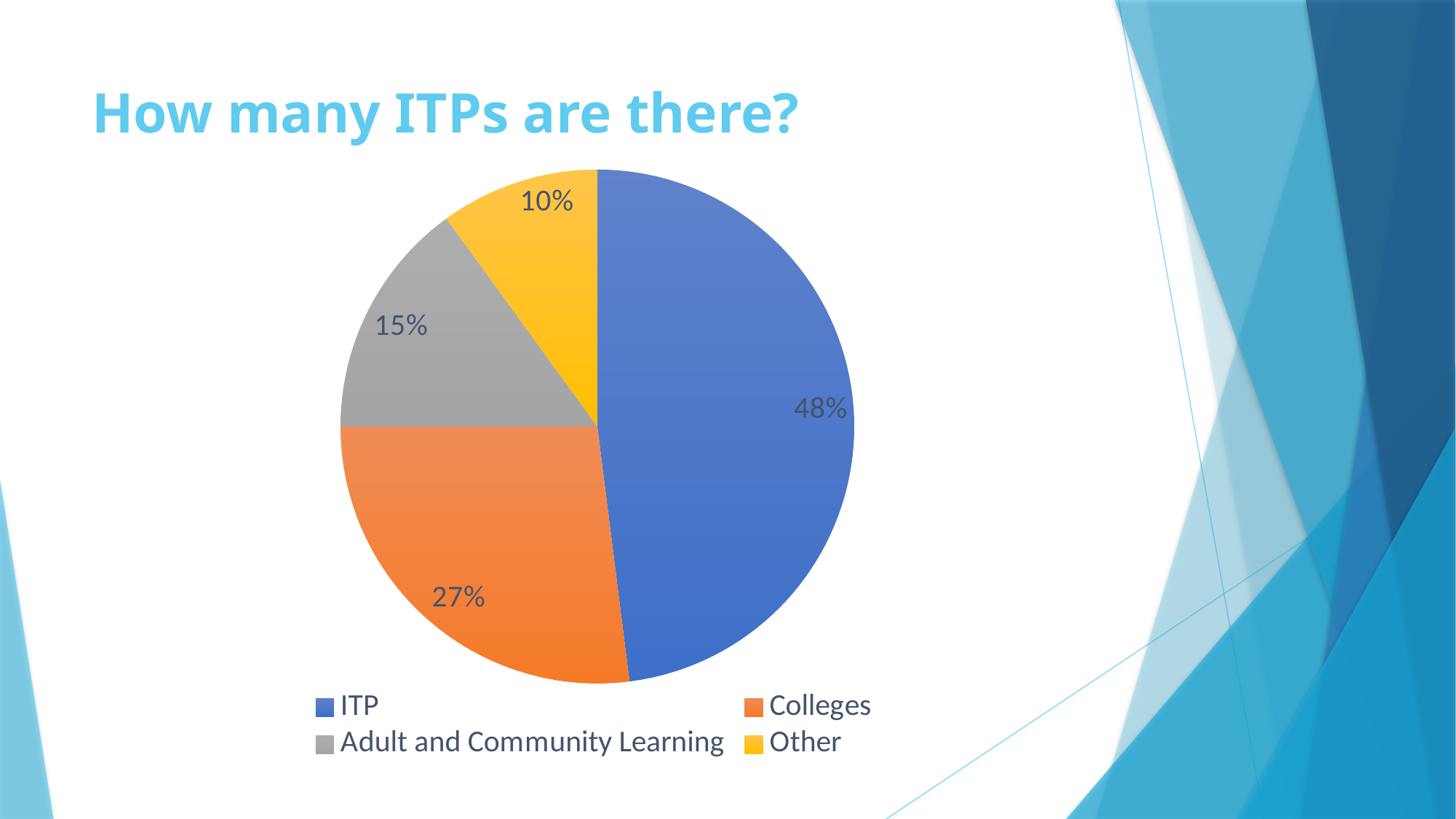
What kind of chart is shown on the slide? Pie chart Which category has the largest slice of the pie? ITP Which category has the smallest slice of the pie? Other What share of the pie does Colleges account for? 27% What share of the pie does Other account for? 10% What colour is the Colleges slice in the pie chart? Orange How many categories are shown in the pie chart? 4 Which is larger, the Colleges slice or the Adult and Community Learning slice? Colleges What is the difference in percentage points between the Adult and Community Learning slice and the Other slice? 5 What share of the pie does ITP account for? 48% What is the difference in percentage points between the ITP slice and the Colleges slice? 21